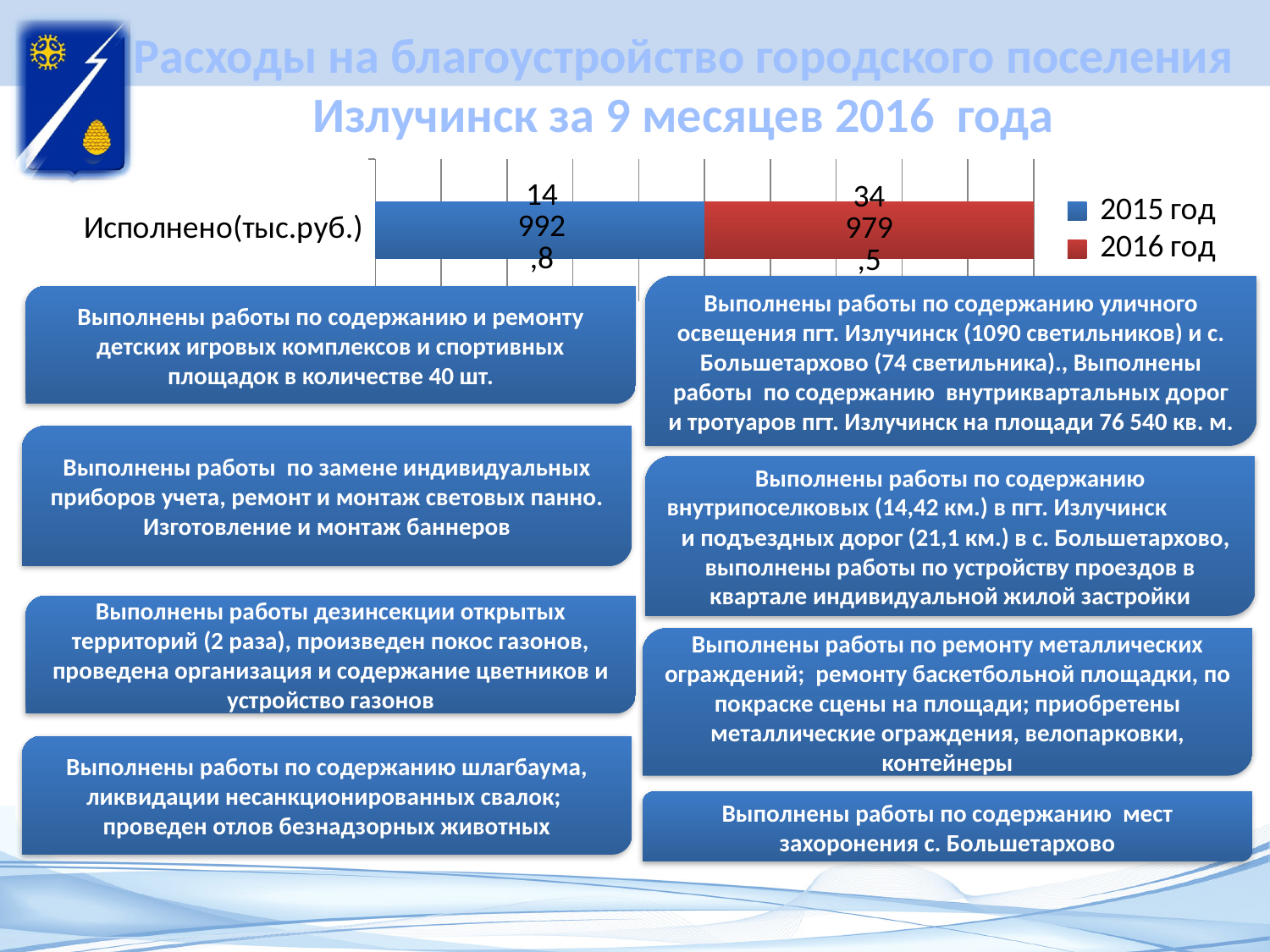
What is the difference between the 2016 год value and the 2015 год value? 19 986,7 Which series has the lowest value in the chart? 2015 год Which series has the highest value in the chart? 2016 год What is the total of the stacked bar for Исполнено(тыс.руб.)? 49 972,3 Which series has the larger value, 2015 год or 2016 год? 2016 год What is the value for the 2016 год series in the chart? 34 979,5 Which colour represents the 2016 год series in the chart? Red What kind of chart is shown on the slide? Stacked horizontal bar chart How many series does the legend list? 2 What is the value for the 2015 год series in the chart? 14 992,8 What is the label of the category plotted in the chart? Исполнено(тыс.руб.) How many categories are plotted in the chart? 1